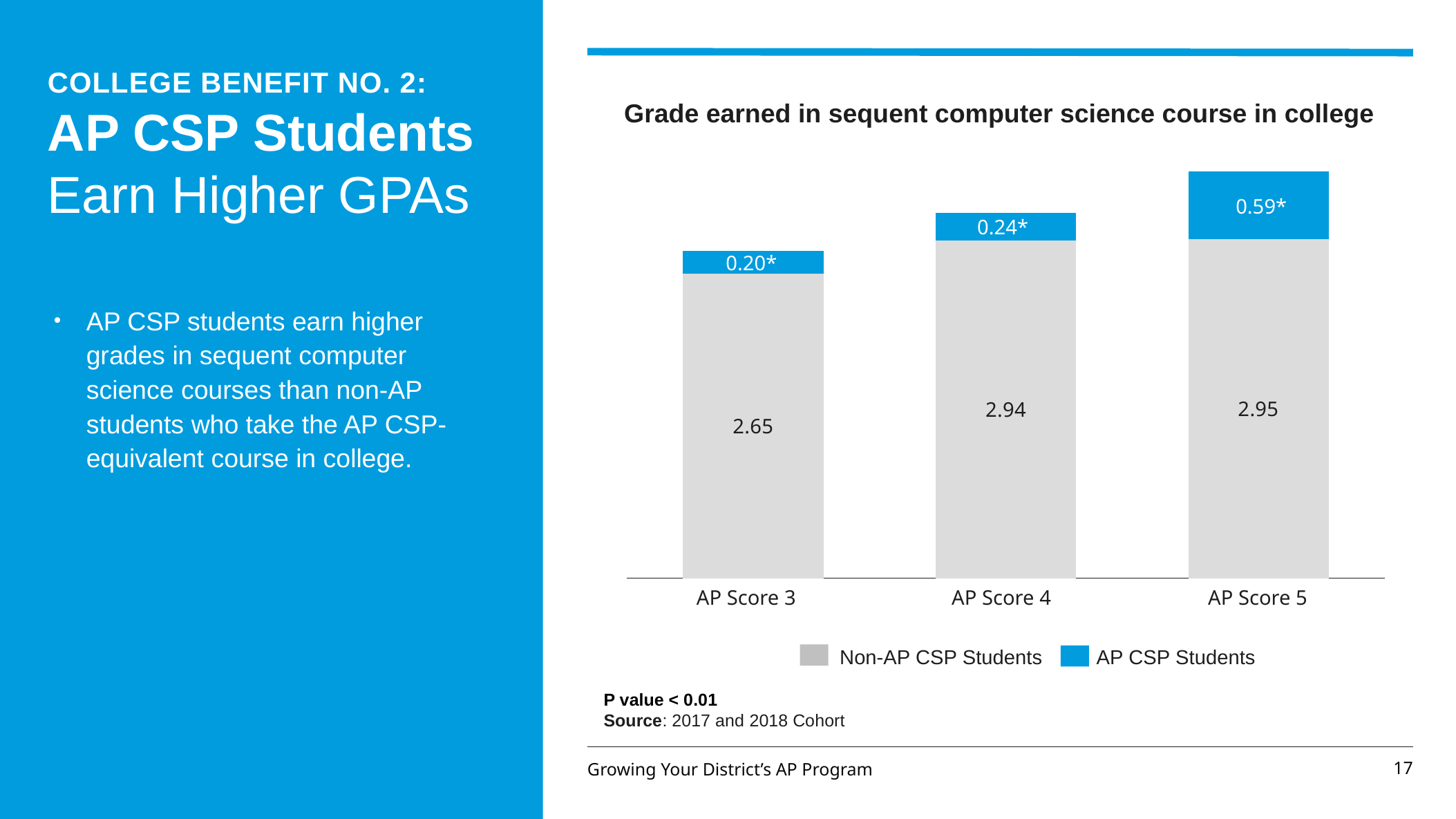
What is the total of the stacked bar for AP Score 5? 3.54 What is the difference between the AP CSP Students values at AP Score 5 and AP Score 3? 0.39 Which AP Score category has the lowest value for Non-AP CSP Students? AP Score 3 How many AP Score categories are shown on the x axis? 3 How many series does the legend list? 2 Is the Non-AP CSP Students value larger at AP Score 4 or AP Score 3? AP Score 4 What kind of chart is shown on the slide? Stacked bar chart What is the value for Non-AP CSP Students at AP Score 4? 2.94 Which AP Score category has the highest value for AP CSP Students? AP Score 5 What is the value for Non-AP CSP Students at AP Score 3? 2.65 What is the value for AP CSP Students at AP Score 5? 0.59* What is the value for AP CSP Students at AP Score 4? 0.24*